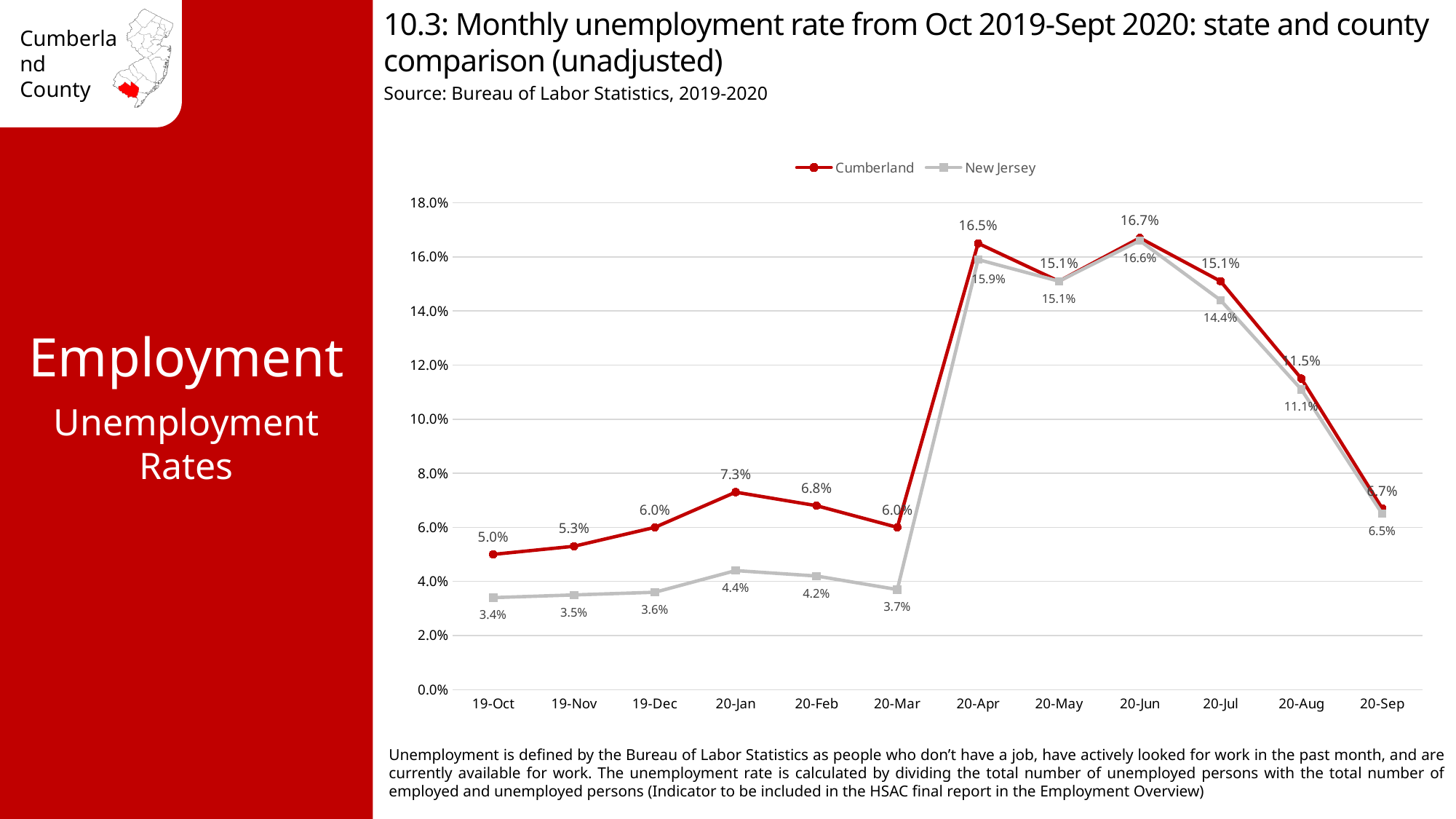
How many months are shown on the x axis of the chart? 12 What was the Cumberland unemployment rate in 20-Jan? 7.3% Which series had the higher unemployment rate in 20-Jul, Cumberland or New Jersey? Cumberland What is the difference between the Cumberland and New Jersey unemployment rates in 20-Mar? 2.3% Is the Cumberland unemployment rate in 20-Apr greater or less than 16.0%? greater In which month was the New Jersey unemployment rate lowest? 19-Oct What was the Cumberland unemployment rate in 20-Aug? 11.5% What was the New Jersey unemployment rate in 20-Apr? 15.9% What type of chart is used to show the unemployment rates? Line chart How many series does the chart legend list? 2 Did the Cumberland unemployment rate rise or fall from 20-Jun to 20-Sep? Fall In which month did the Cumberland unemployment rate reach its highest value? 20-Jun